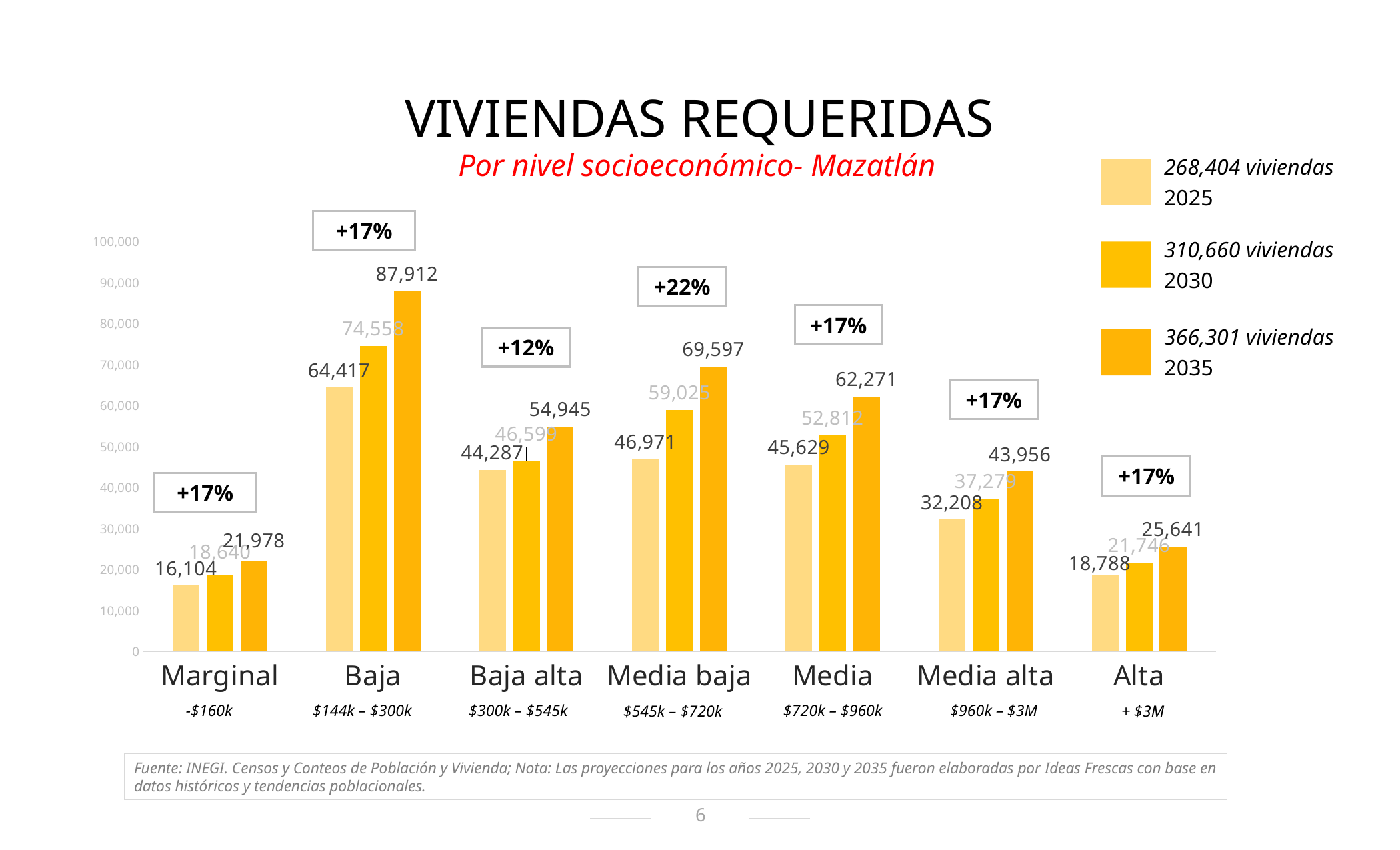
What kind of chart is shown on the slide? Bar chart How many socioeconomic categories are shown on the x axis? 7 What is the value for Media baja in the 2025 series? 46,971 Which category has the highest value in the 2035 series? Baja What is the value for Baja in the 2035 series? 87,912 What percentage increase is shown in the box above the Media baja group? +22% What is the difference between the 2035 and 2030 values for Media baja? 10,572 How many series does the legend list? 3 What is the difference between the 2035 and 2025 values for Baja? 23,495 Which category has the lowest value in the 2025 series? Marginal Which is larger: the 2035 value for Media or the 2035 value for Media baja? Media baja What is the value for Alta in the 2030 series? 21,746